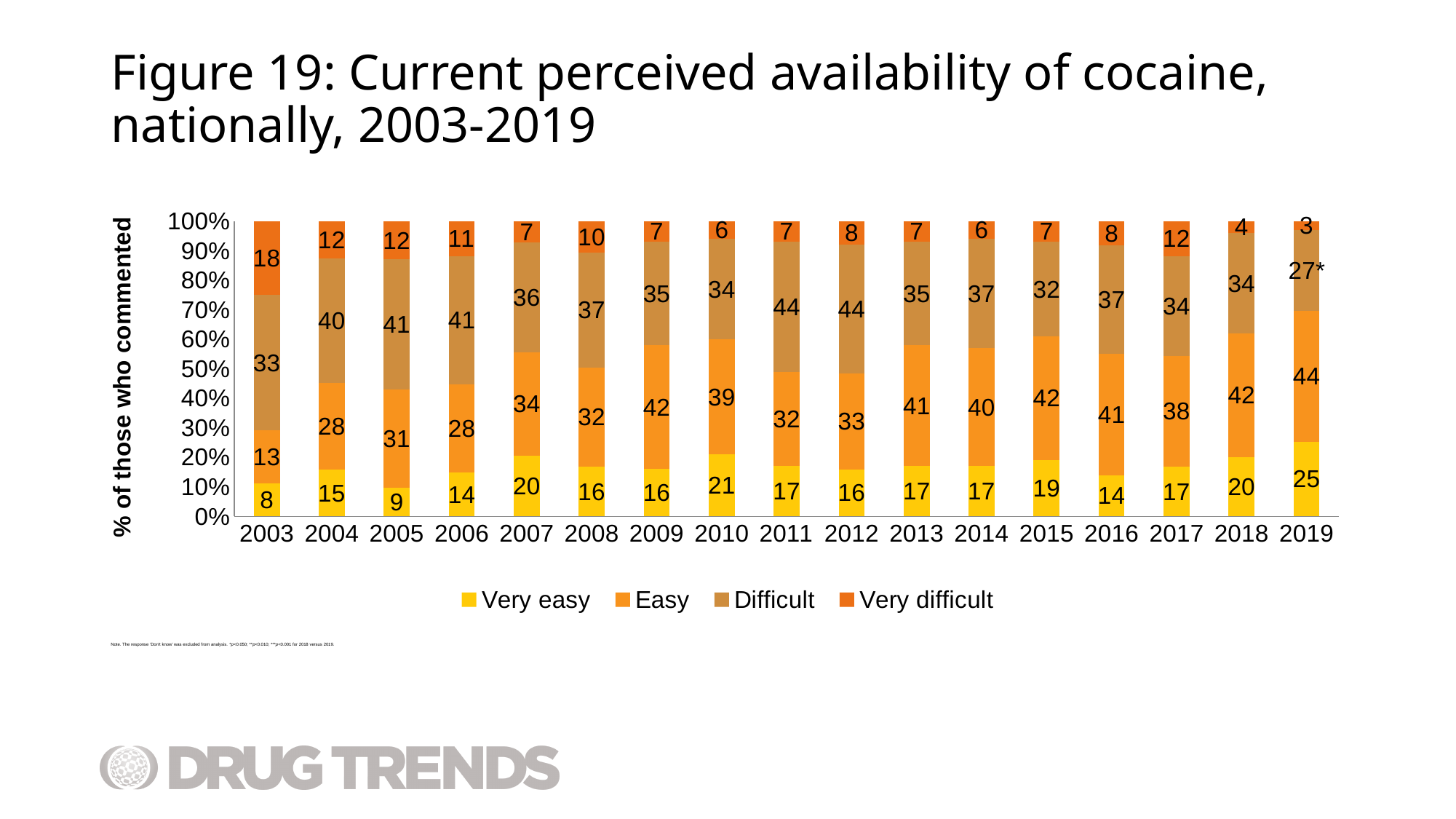
How many series does the legend list? 4 In which year is the 'Very easy' value lowest? 2003 What is the 'Difficult' value for 2011? 44 Does the 'Very difficult' value rise or fall from 2017 to 2019? Fall How many years are shown on the x axis? 17 Which is larger, the 'Difficult' value for 2012 or for 2019? 2012 What is the label of the y axis? % of those who commented What percentage of respondents rated cocaine as 'Very easy' to obtain in 2019? 25 What kind of chart is shown on the slide? Stacked bar chart What is the 'Very difficult' value for 2003? 18 In which year is the 'Very easy' value highest? 2019 What is the difference between the 'Easy' values for 2019 and 2003? 31